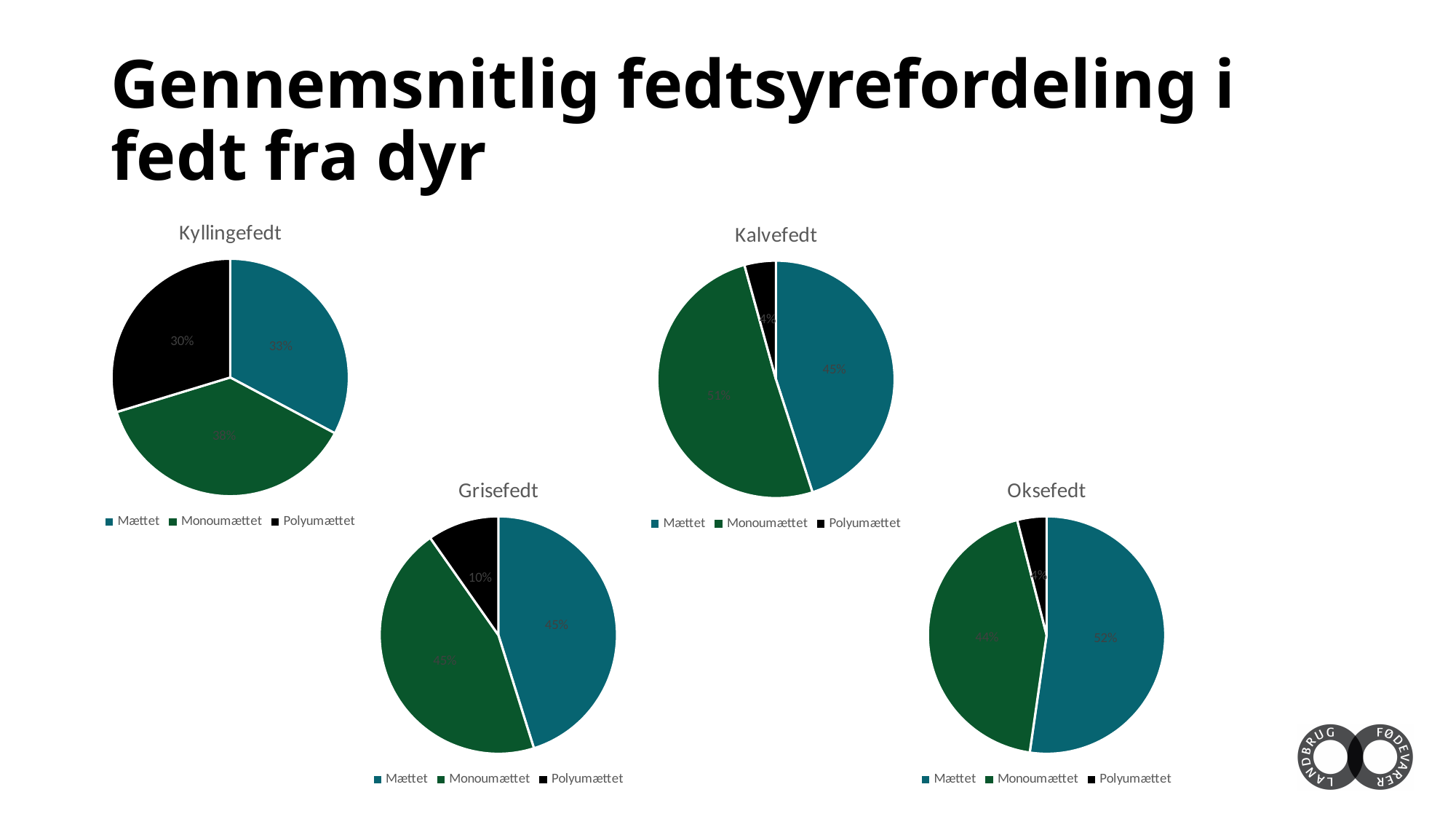
In the Grisefedt chart, is the Mættet slice larger or smaller than the Polyumættet slice? larger In the Oksefedt chart, what is the difference between the Mættet and Monoumættet shares? 8% In the Kyllingefedt chart, what share is Monoumættet? 38% In the Kalvefedt chart, what share is Monoumættet? 51% In the Oksefedt chart, what share is Mættet? 52% How many entries does the legend of the Kyllingefedt chart list? 3 In the Kalvefedt chart, which category has the smallest slice? Polyumættet In the Kyllingefedt chart, what share is Polyumættet? 30% In the Grisefedt chart, what share is Polyumættet? 10% How many pie charts are on the slide? 4 In the Oksefedt chart, which category has the largest slice? Mættet In the Kalvefedt chart, what share is Polyumættet? 4%